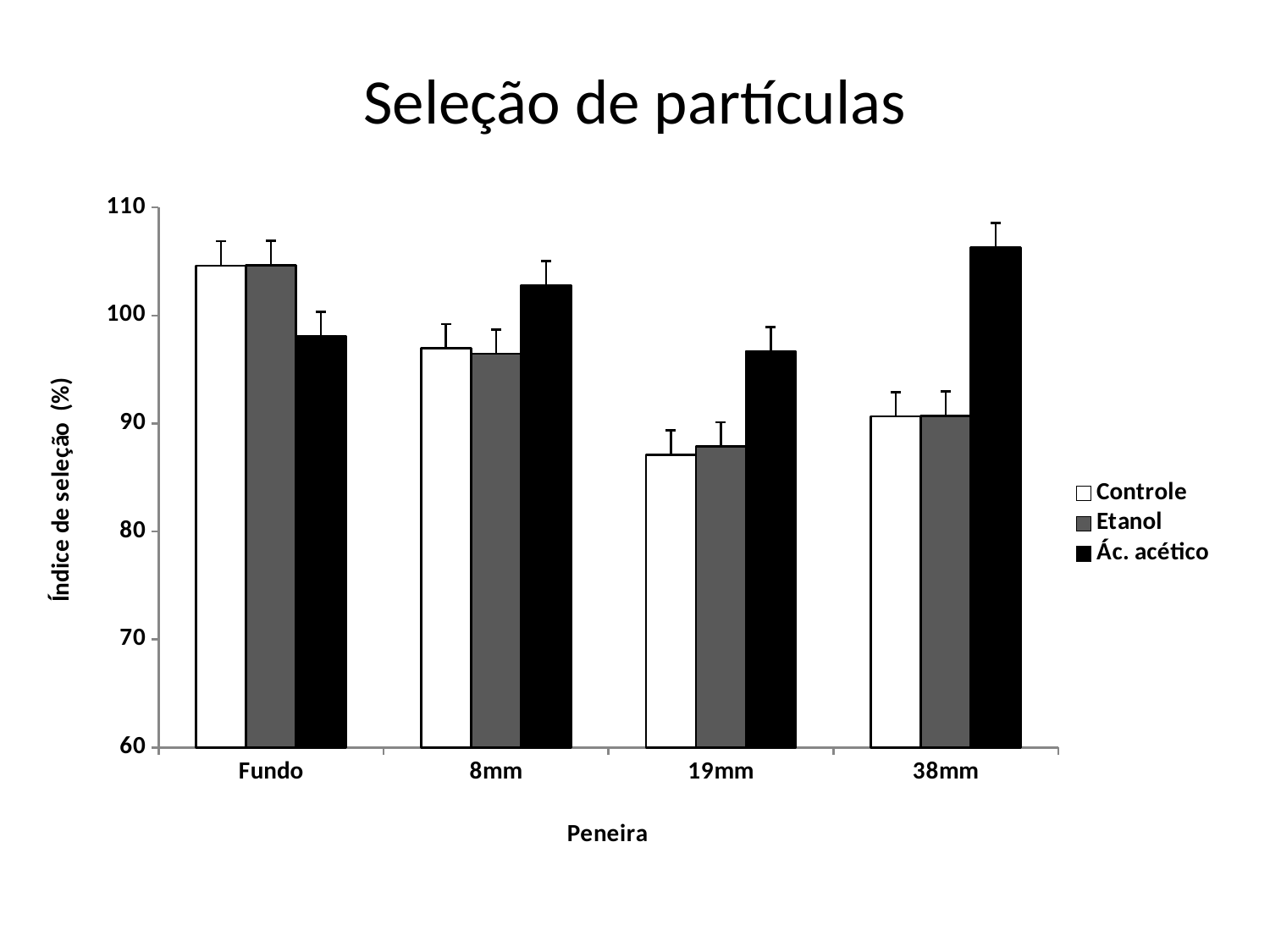
How many categories are shown on the x axis? 4 What kind of chart is shown on the slide? bar chart For which category is the Controle value lowest? 19mm Is the Ác. acético value for 38mm greater or less than 100? greater What is the title of the y axis? Índice de seleção (%) For which category is the Ác. acético value highest? 38mm For which category is the Controle value highest? Fundo At 19mm, which is larger: the Controle value or the Ác. acético value? Ác. acético Is the Ác. acético value for Fundo greater or less than 100? less How many series does the legend list? 3 Is the Controle value for 19mm greater or less than 90? less At Fundo, which is larger: the Controle value or the Ác. acético value? Controle